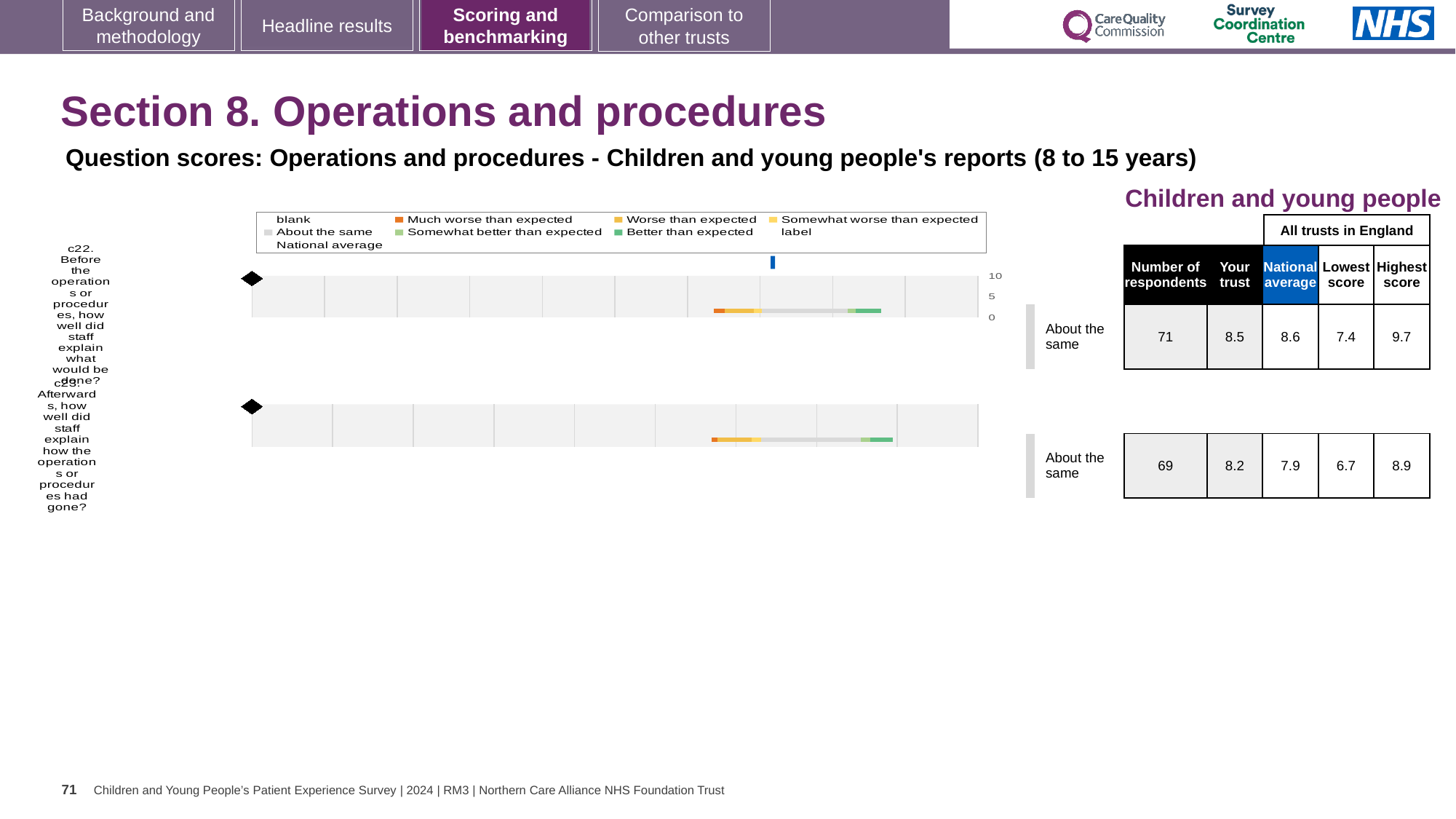
For the c22 chart, which is larger: the 'Your trust' score or the national average? National average For the c23 chart (Afterwards, how well did staff explain how the operations or procedures had gone?), what is the national average score? 7.9 For the c23 chart, how many respondents are there? 69 In the chart legend, what colour represents 'Better than expected'? green What kind of chart is used to show the question scores for c22 and c23? bar chart For the c22 chart, what is the difference between the highest score and the lowest score across all trusts in England? 2.3 How many question charts (c22 and c23) are shown on the slide? 2 For the c22 chart (Before the operations or procedures, how well did staff explain what would be done?), what is the 'Your trust' score? 8.5 In the chart legend, what colour represents 'Much worse than expected'? orange For the c23 chart, which is larger: the 'Your trust' score or the national average? Your trust For the c23 chart, what is the highest score across all trusts in England? 8.9 What benchmark category is shown next to both the c22 and c23 charts? About the same